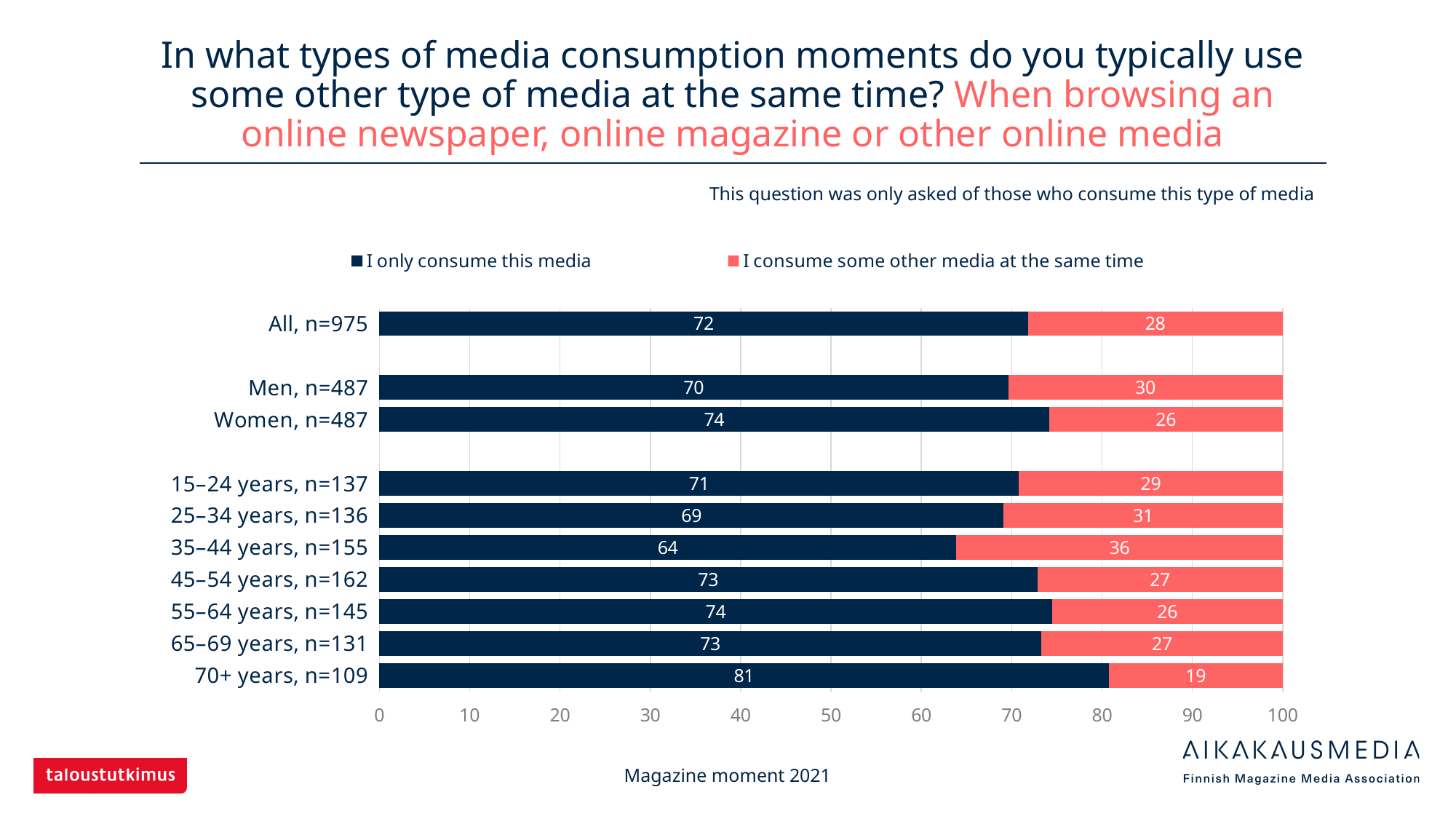
What is the value of "I only consume this media" for All, n=975? 72 How many series does the legend list? 2 How many categories are shown on the chart? 10 What is the value of "I only consume this media" for 70+ years, n=109? 81 What is the difference between the "I only consume this media" values for Women, n=487 and Men, n=487? 4 What kind of chart is shown on the slide? Stacked bar chart What is the value of "I consume some other media at the same time" for 35–44 years, n=155? 36 Which category has the lowest value for "I only consume this media"? 35–44 years, n=155 Which is larger: the "I consume some other media at the same time" value for 25–34 years, n=136 or for 45–54 years, n=162? 25–34 years, n=136 What is the total of the stacked bar for 55–64 years, n=145? 100 Which category has the highest value for "I only consume this media"? 70+ years, n=109 Which category has the lowest value for "I consume some other media at the same time"? 70+ years, n=109